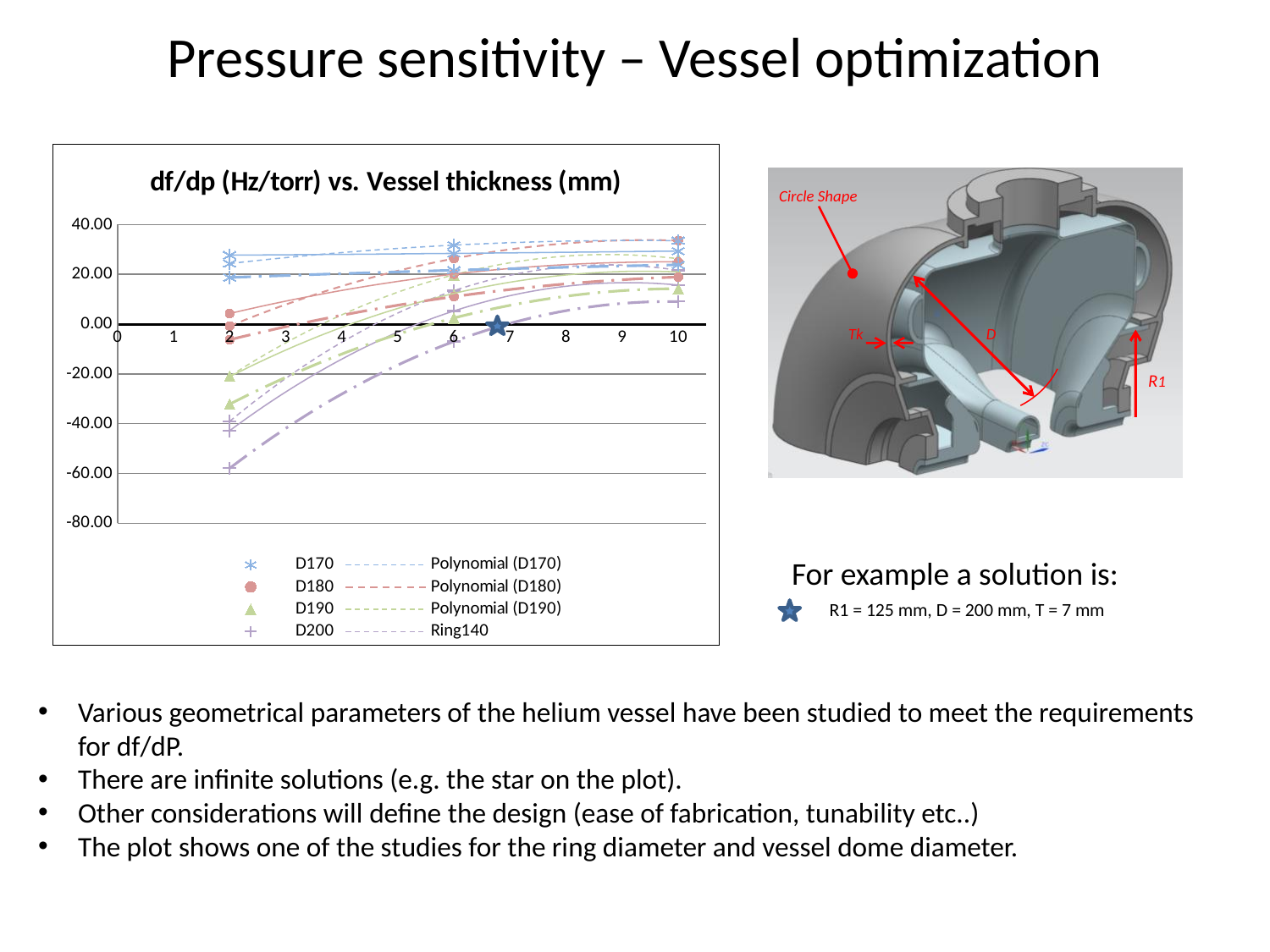
Is the D200 value at a vessel thickness of 2 mm greater or less than -20.00? less At a vessel thickness of 2 mm, which series has the highest df/dp value? D170 Does the D200 series rise or fall as vessel thickness increases? rise How many entries does the chart legend list? 8 What kind of chart is shown on the slide? scatter chart At a vessel thickness of 2 mm, which is larger: the D170 value or the D200 value? D170 Is the D180 value at a vessel thickness of 10 mm greater or less than 0.00? greater Is the D190 value at a vessel thickness of 2 mm greater or less than 0.00? less What is the lowest value shown on the chart's vertical axis? -80.00 At a vessel thickness of 2 mm, which series has the lowest df/dp value? D200 What is the title of the chart on the slide? df/dp (Hz/torr) vs. Vessel thickness (mm)